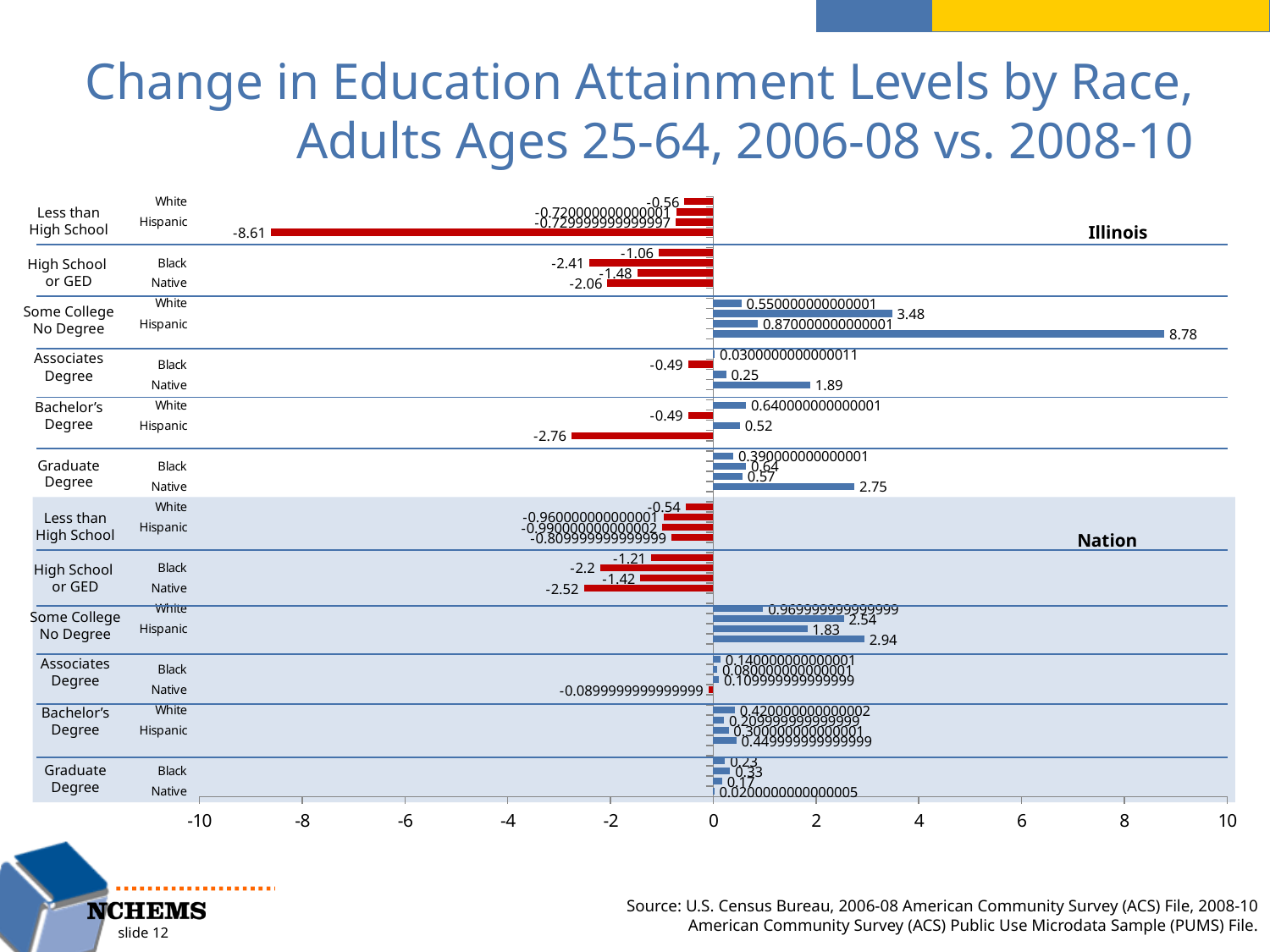
What is the highest value shown anywhere on the chart? 8.78 What is the lowest (most negative) value shown anywhere on the chart? -8.61 In the Illinois section, what is the value of the longest bar for Some College No Degree? 8.78 Which section has the larger maximum value for Some College No Degree, Illinois or Nation? Illinois In the Illinois section, what is the value of the longest bar for Graduate Degree? 2.75 In the Nation section, what is the value of the longest bar for Some College No Degree? 2.94 What kind of chart is shown on the slide? bar chart In the Illinois section, what is the most negative value shown for Bachelor's Degree? -2.76 In the Nation section, what is the most negative value shown for High School or GED? -2.52 What is the difference between the largest Some College No Degree value for Illinois (8.78) and for the Nation (2.94)? 5.84 How many education attainment categories are listed in each section of the chart? 6 Is the most negative value in the Illinois Less than High School group greater or less than -8? less